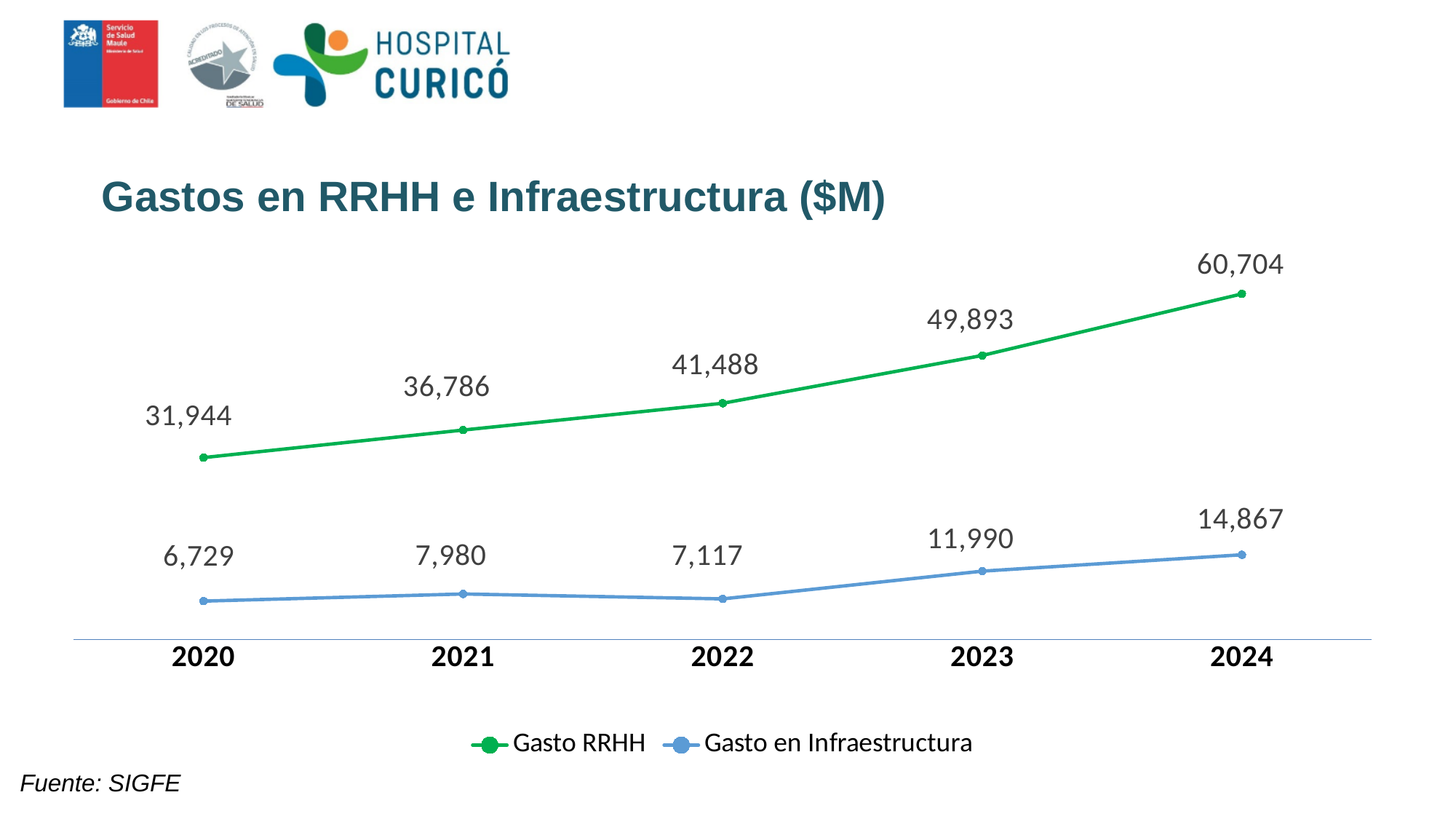
What is the value of Gasto RRHH in 2022? 41,488 What is the value of Gasto RRHH in 2020? 31,944 What is the difference between Gasto RRHH and Gasto en Infraestructura in 2020? 25,215 What is the difference between Gasto RRHH in 2024 and in 2023? 10,811 In which year is Gasto RRHH highest? 2024 Does Gasto RRHH rise or fall from 2020 to 2024? Rise What is the value of Gasto en Infraestructura in 2023? 11,990 Which is larger: Gasto en Infraestructura in 2021 or in 2022? 2021 What kind of chart is shown on the slide? Line chart How many series does the legend list? 2 How many years are shown on the x axis? 5 In which year is Gasto en Infraestructura lowest? 2020